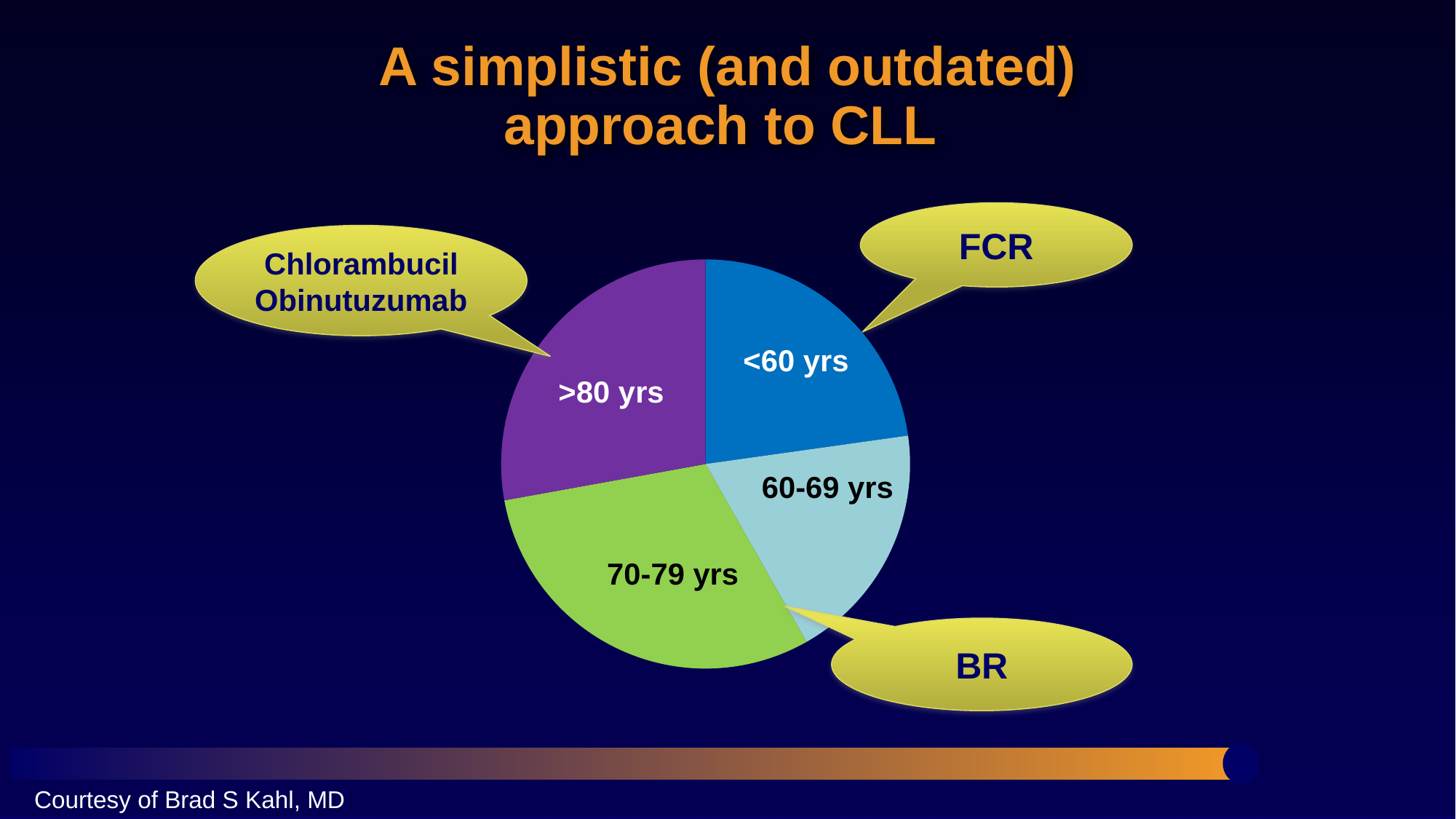
How many slices does the pie chart have? 4 What kind of chart is shown on the slide? pie chart Which age group has the largest slice of the pie chart? 70-79 yrs Which slice is larger, >80 yrs or 60-69 yrs? >80 yrs Which slice is larger, 70-79 yrs or 60-69 yrs? 70-79 yrs Which treatment callout points to the <60 yrs slice? FCR Which age group has the smallest slice of the pie chart? 60-69 yrs